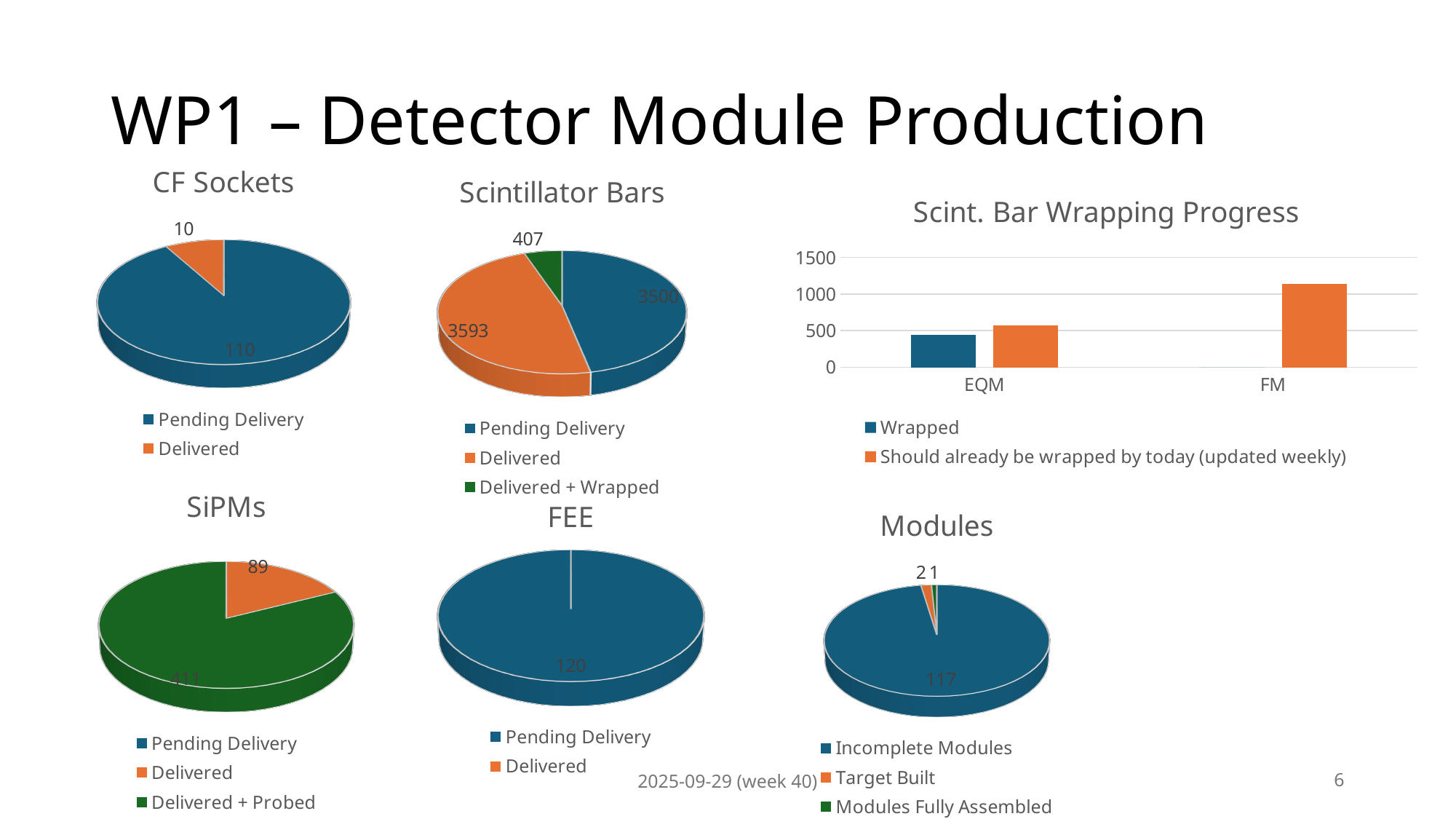
In the Scintillator Bars pie chart, what is the value for Delivered + Wrapped? 407 In the CF Sockets pie chart, what is the value for Pending Delivery? 110 In the Scintillator Bars pie chart, what is the total of all slices? 7500 In the Scintillator Bars pie chart, how many slices are there? 3 In the FEE pie chart, what is the value for Pending Delivery? 120 How many series does the legend of the Scint. Bar Wrapping Progress chart list? 2 In the Scintillator Bars pie chart, what is the value for Delivered? 3593 In the CF Sockets pie chart, what is the difference between Pending Delivery and Delivered? 100 In the CF Sockets pie chart, what is the value for Delivered? 10 What kind of chart is the Scint. Bar Wrapping Progress chart? bar chart In the Scint. Bar Wrapping Progress chart, is the value for FM 'Should already be wrapped by today' greater or less than 1000? greater In the Scint. Bar Wrapping Progress chart, is the value for EQM Wrapped greater or less than 500? less